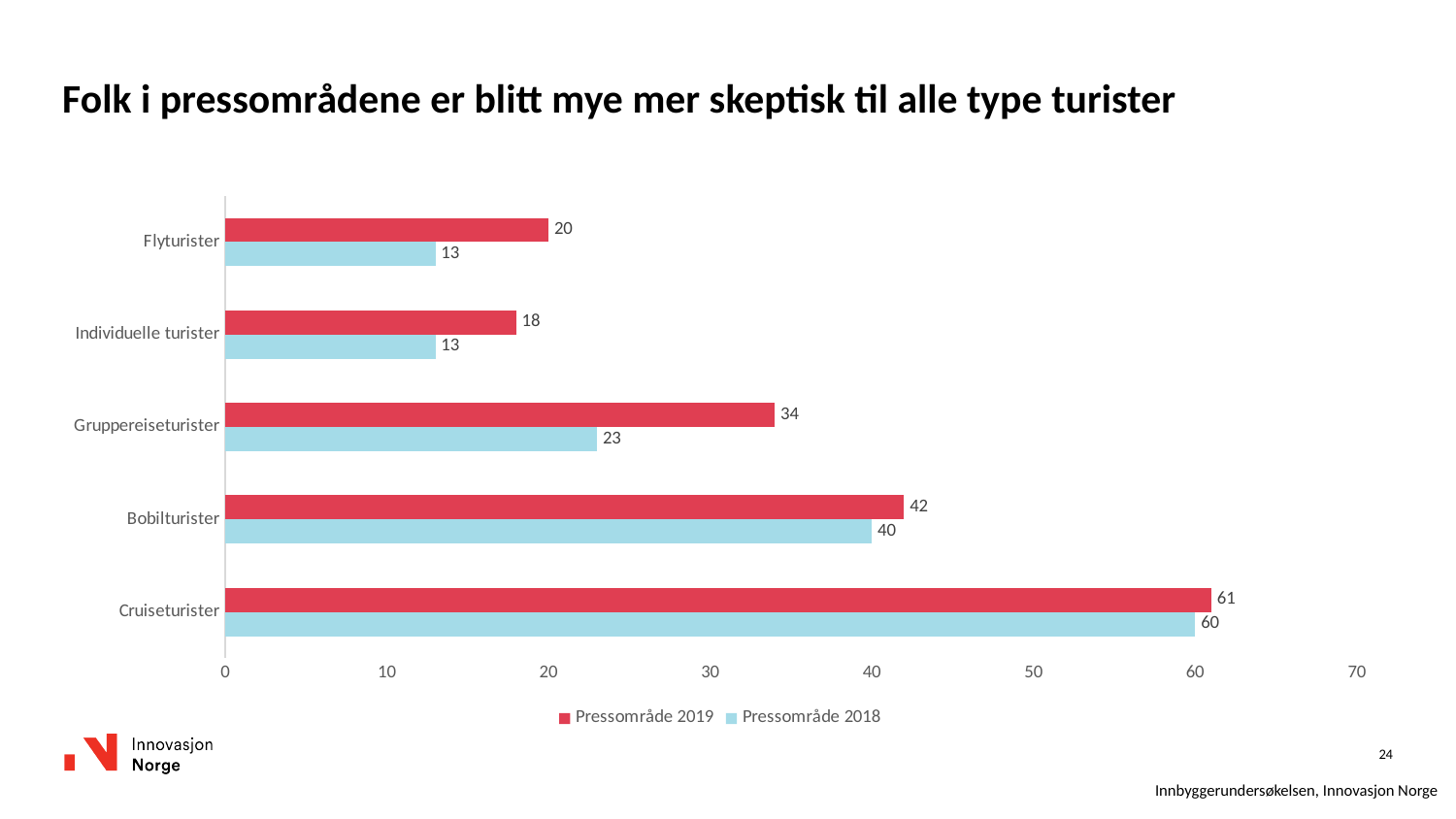
What is the value for Cruiseturister in the Pressområde 2019 series? 61 How many series does the legend list? 2 Which is larger: the Pressområde 2019 value for Bobilturister or the Pressområde 2019 value for Grupperreiseturister? Bobilturister What is the value for Grupperreiseturister in the Pressområde 2018 series? 23 How many categories are shown on the chart? 5 What is the difference between the Pressområde 2019 and Pressområde 2018 values for Flyturister? 7 What is the difference between the Pressområde 2019 and Pressområde 2018 values for Grupperreiseturister? 11 What kind of chart is shown on the slide? Bar chart What is the value for Flyturister in the Pressområde 2018 series? 13 What is the title of the slide? Folk i pressområdene er blitt mye mer skeptisk til alle type turister Which category has the highest value in the Pressområde 2019 series? Cruiseturister Which category has the lowest value in the Pressområde 2019 series? Individuelle turister